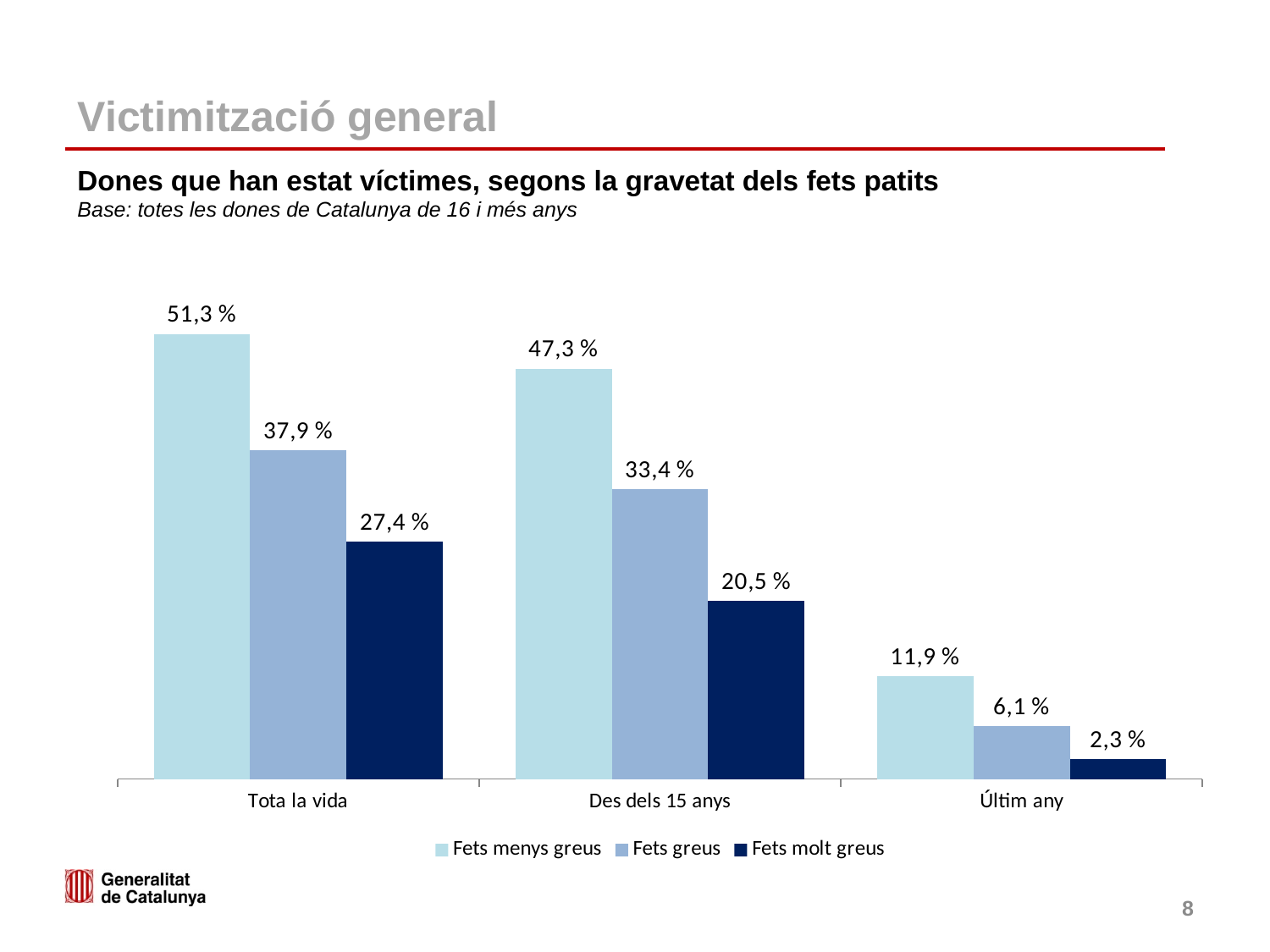
Which category has the highest value for 'Fets menys greus'? Tota la vida Which series is shown in the darkest blue colour? Fets molt greus Which category has the lowest value for 'Fets greus'? Últim any What is the value for 'Fets molt greus' in the 'Últim any' category? 2,3 % Do the values for 'Fets molt greus' rise or fall from 'Tota la vida' to 'Últim any'? Fall What is the difference between 'Fets menys greus' and 'Fets molt greus' in the 'Tota la vida' category? 23,9 % What kind of chart is shown on the slide? Bar chart What is the value for 'Fets greus' in the 'Des dels 15 anys' category? 33,4 % What is the value for 'Fets menys greus' in the 'Tota la vida' category? 51,3 % How many categories are shown on the x axis? 3 How many series does the legend list? 3 Which is larger: 'Fets greus' for 'Tota la vida' or 'Fets menys greus' for 'Últim any'? Fets greus for Tota la vida